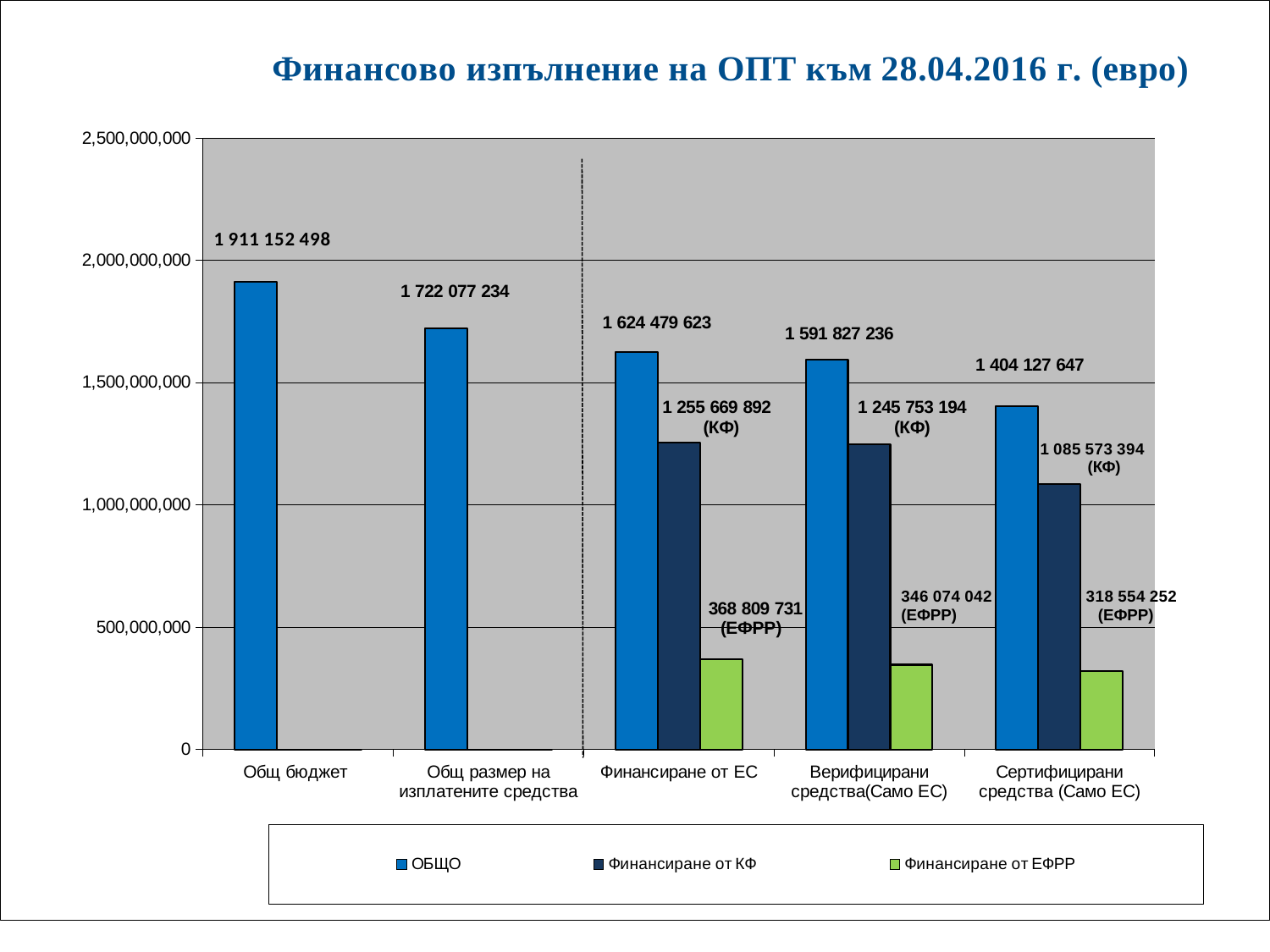
What is the ОБЩО value for Общ размер на изплатените средства? 1 722 077 234 Which category has the lowest Финансиране от ЕФРР value? Сертифицирани средства (Само ЕС) Which is larger: the ОБЩО value for Верифицирани средства(Само ЕС) or for Сертифицирани средства (Само ЕС)? Верифицирани средства(Само ЕС) What kind of chart is shown on the slide? Bar chart What is the difference between the Финансиране от ЕФРР values for Финансиране от ЕС and Сертифицирани средства (Само ЕС)? 50 255 479 What is the difference between the ОБЩО values for Общ бюджет and Общ размер на изплатените средства? 189 075 264 Which category has the highest ОБЩО value? Общ бюджет What is the Финансиране от КФ value for Финансиране от ЕС? 1 255 669 892 What is the Финансиране от ЕФРР value for Сертифицирани средства (Само ЕС)? 318 554 252 What is the Финансиране от КФ value for Верифицирани средства(Само ЕС)? 1 245 753 194 How many series does the legend list? 3 What is the ОБЩО value for Общ бюджет? 1 911 152 498